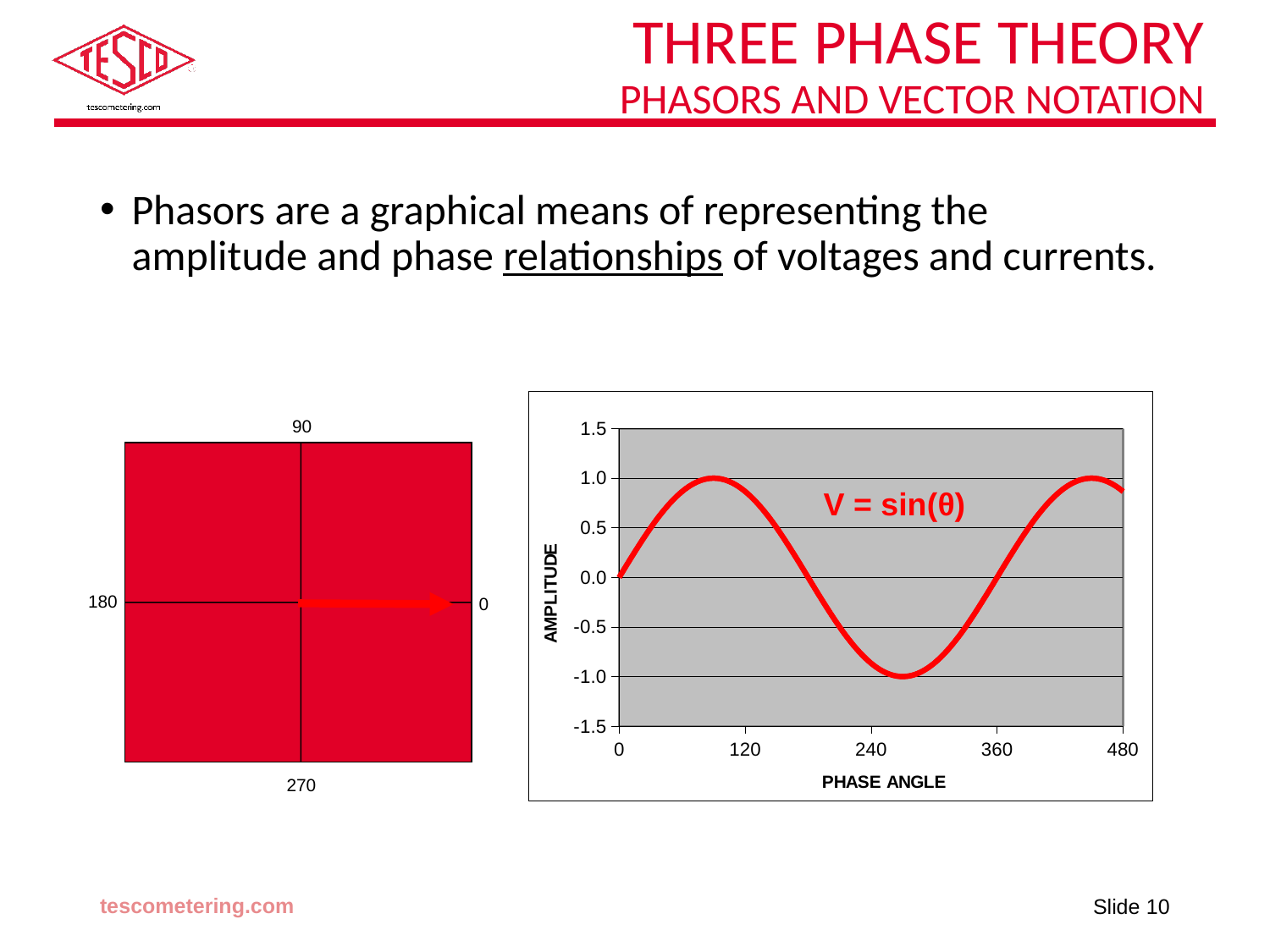
In the line chart, is the amplitude at a phase angle of 480 greater or less than 0.5? greater In the line chart, what is the label on the vertical axis? AMPLITUDE In the line chart, what is the label on the horizontal axis? PHASE ANGLE In the line chart, is the amplitude at a phase angle of 240 greater or less than -0.5? less What kind of chart is shown on the right side of the slide? line chart In the line chart, what is the amplitude at a phase angle of 0? 0.0 In the line chart, does the amplitude rise or fall as the phase angle goes from 120 to 240? fall In the line chart, which has the larger amplitude: phase angle 120 or phase angle 240? 120 In the line chart, what is the amplitude at a phase angle of 360? 0.0 In the line chart, what is the highest amplitude the curve reaches? 1.0 In the line chart, is the amplitude at a phase angle of 120 greater or less than 0.5? greater In the line chart, what is the lowest amplitude the curve reaches? -1.0